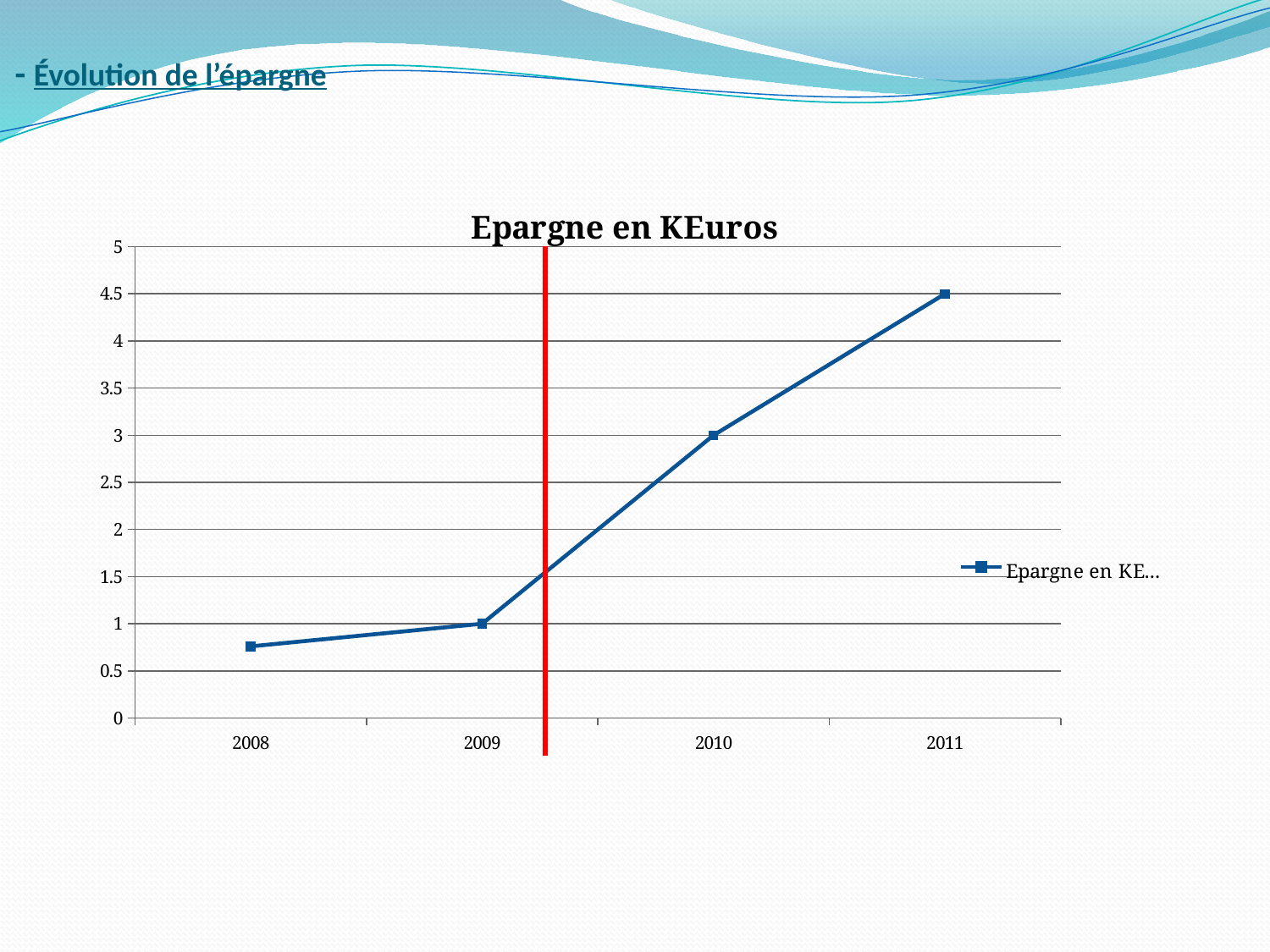
Which year has the lowest value? 2008 What is the value for 2009? 1 Which year has the highest value? 2011 Which is larger, the value for 2009 or the value for 2010? 2010 What is the difference between the values for 2010 and 2009? 2 What is the value for 2010? 3 What is the value for 2011? 4.5 Is the value for 2008 greater or less than 0.5? greater What is the difference between the values for 2011 and 2010? 1.5 Do the values rise or fall from 2008 to 2011? rise How many years are plotted on the x axis? 4 What kind of chart is shown? line chart